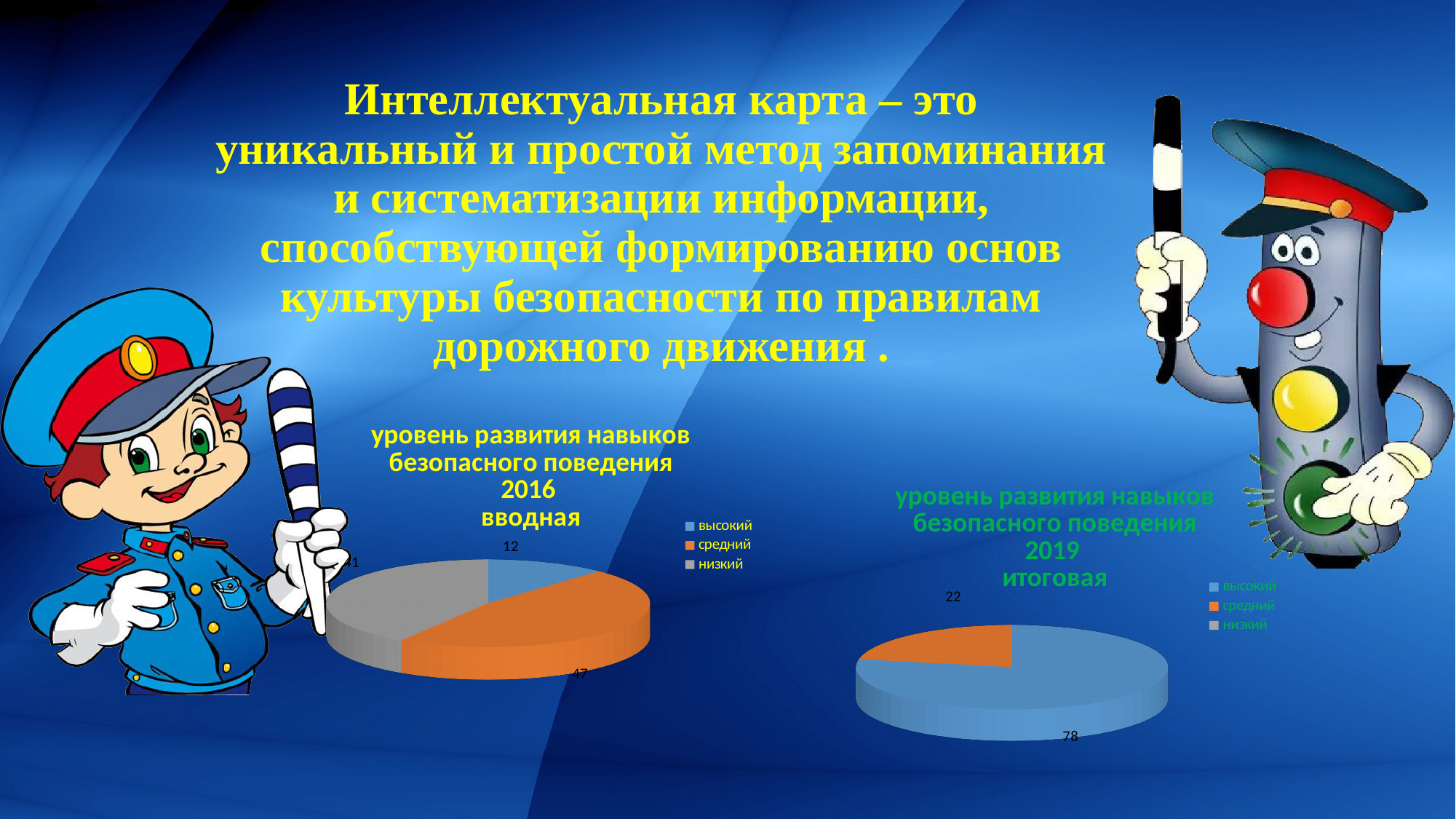
In the 2019 итоговая chart, what is the difference between высокий and средний? 56 In the 2016 вводная chart, which category has the largest slice? средний In the 2016 вводная chart, what colour is the средний slice? orange In the 2016 вводная chart, which category has the smallest slice? высокий How many entries does the legend of the 2019 итоговая chart list? 3 In the 2019 итоговая chart, what is the value for высокий? 78 In the 2016 вводная chart, what is the value for средний? 47 In the 2016 вводная chart, what is the value for высокий? 12 What type of chart is the 2016 вводная chart on the left? pie chart In the 2016 вводная chart, what is the difference between средний and высокий? 35 In the 2019 итоговая chart, which is larger, высокий or средний? высокий In the 2019 итоговая chart, what is the value for средний? 22